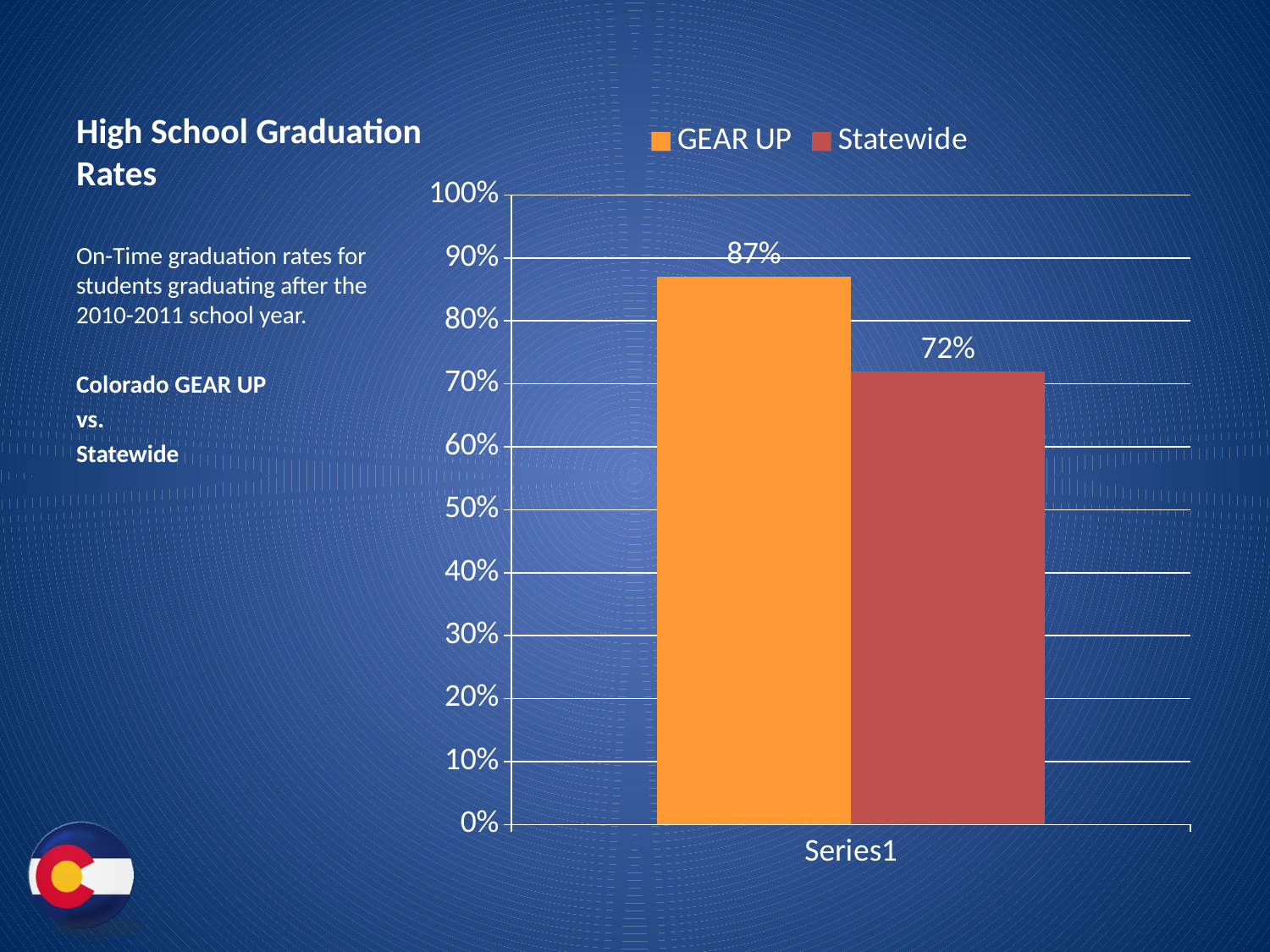
What is the graduation rate for Statewide? 72% What colour is the GEAR UP bar? orange What is the graduation rate for GEAR UP? 87% What is the difference between the GEAR UP and Statewide graduation rates? 15% Which series has the lowest value on the chart? Statewide Which series has the higher graduation rate, GEAR UP or Statewide? GEAR UP What kind of chart is shown on the slide? bar chart How many series does the legend list? 2 What is the label on the x axis under the bars? Series1 Which series has the highest value on the chart? GEAR UP Is the value for Statewide greater or less than 80%? less Is the value for GEAR UP greater or less than 80%? greater